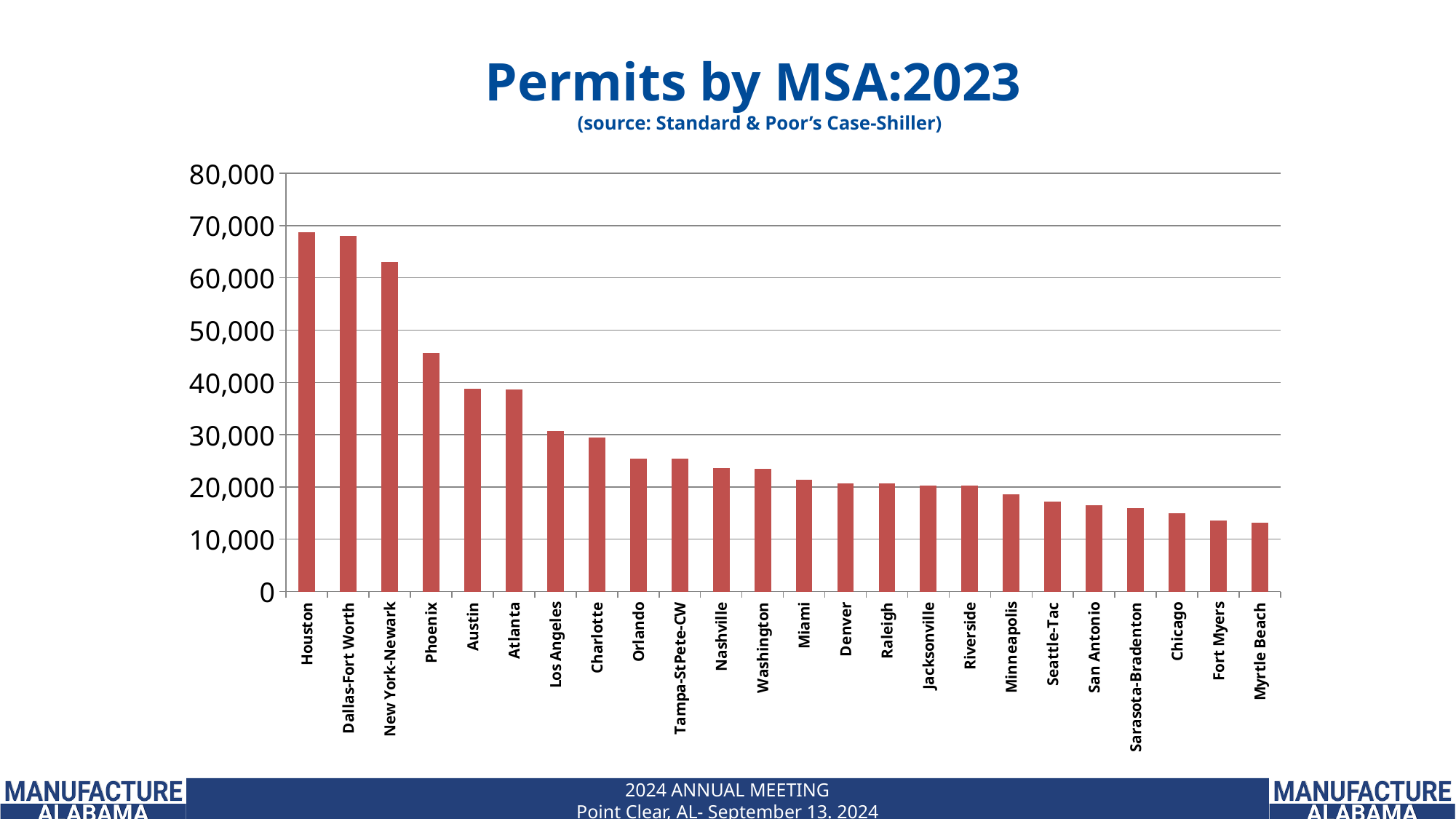
What kind of chart is shown on the slide? bar chart Is the value for Chicago greater or less than 20,000? less Do the values rise or fall moving from left to right along the x axis? fall How many MSAs are plotted on the chart? 24 Which MSA has the highest number of permits? Houston Is the value for Austin greater or less than 40,000? less Is the value for Orlando greater or less than 20,000? greater What is the title of the chart? Permits by MSA:2023 Which has more permits, Phoenix or Austin? Phoenix Which has more permits, Atlanta or Los Angeles? Atlanta